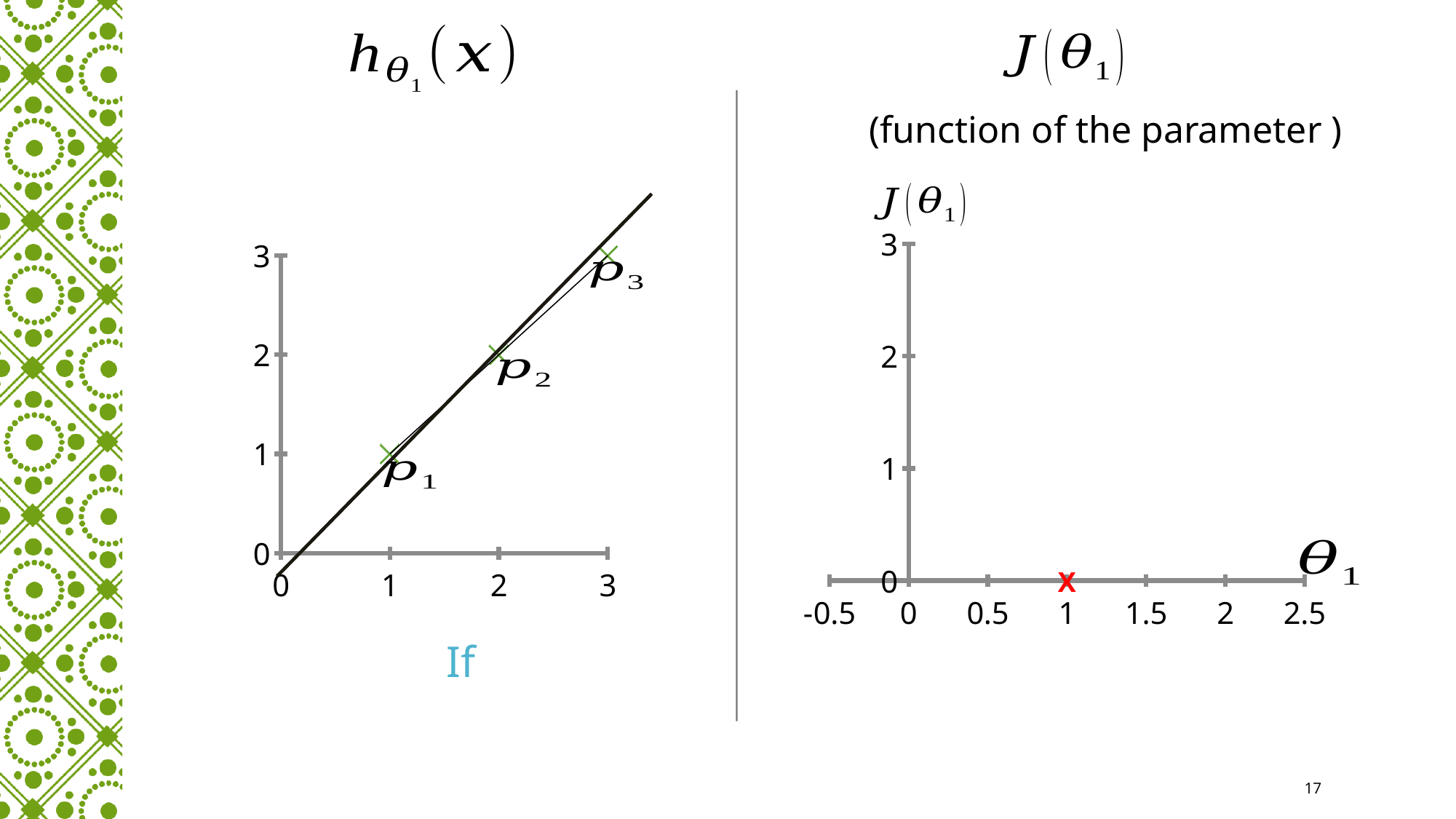
On the left chart h_θ1(x), what is the y value of point p1? 1 On the right chart J(θ1), how many points are plotted? 1 On the left chart h_θ1(x), which point has the highest y value? p3 On the left chart h_θ1(x), what is the x value of point p3? 3 On the right chart J(θ1), what is the J(θ1) value of the red x marker? 0 On the left chart h_θ1(x), how many data points are plotted? 3 On the left chart h_θ1(x), what is the y value of point p2? 2 On the right chart J(θ1), at what value of θ1 is the red x marker plotted? 1 On the left chart h_θ1(x), do the y values rise or fall as x increases? rise On the left chart h_θ1(x), what is the difference between the y values of p3 and p1? 2 On the right chart J(θ1), what is the lowest tick label on the horizontal axis? -0.5 On the left chart h_θ1(x), which point has the lowest y value? p1